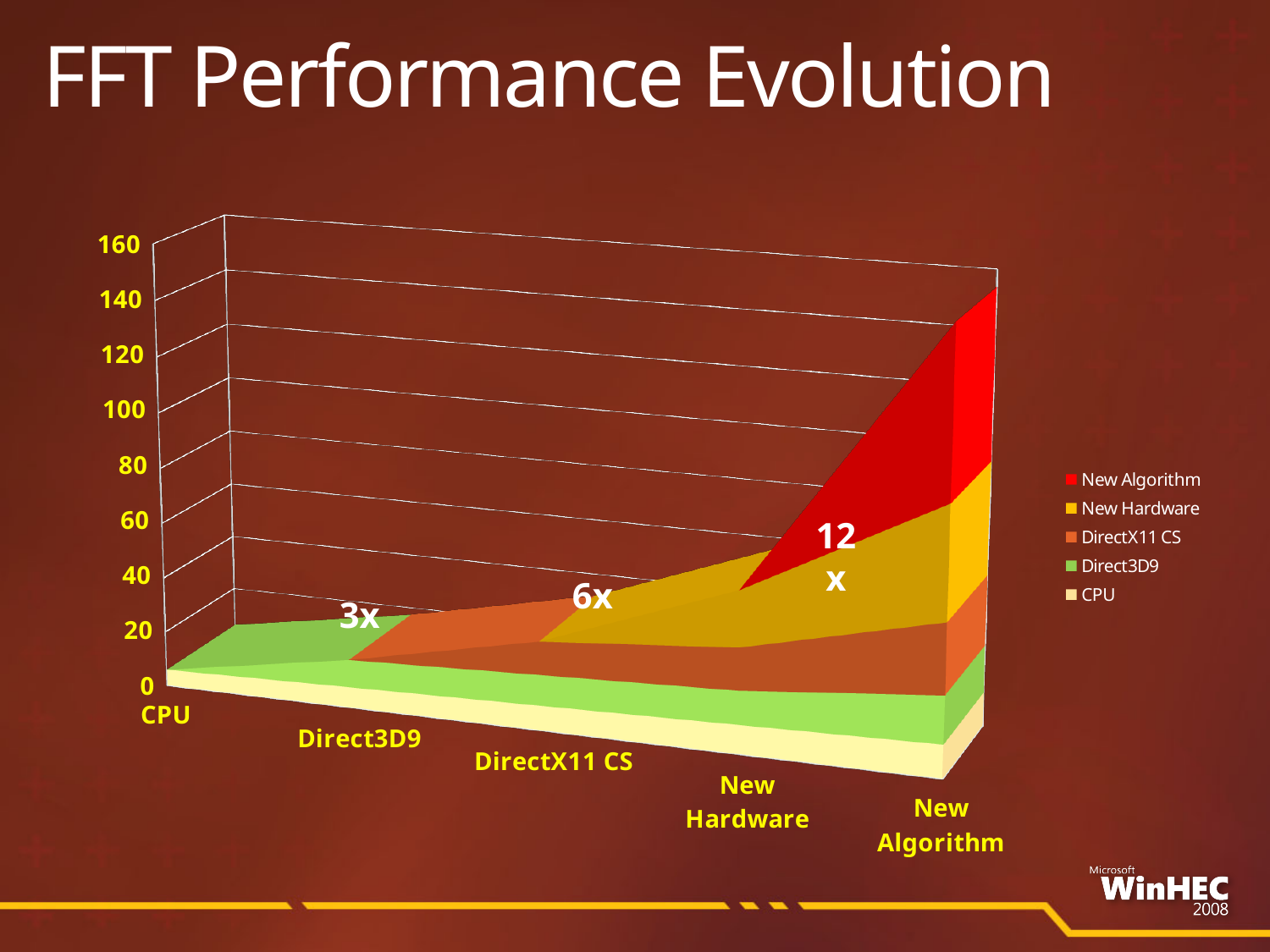
How many series does the legend list? 5 How many categories are shown along the x axis? 5 Which is larger, the value for New Hardware or the value for Direct3D9? New Hardware Is the value for New Algorithm greater or less than 100? greater Which category reaches the highest value? New Algorithm Do the values rise or fall moving from CPU to New Algorithm along the x axis? rise What kind of chart is shown on the slide? area chart Which category has the lowest value? CPU What colour does the legend use for the New Algorithm series? red What is the title of the chart? FFT Performance Evolution Is the value for CPU greater or less than 20? less Is the value for Direct3D9 greater or less than 40? less